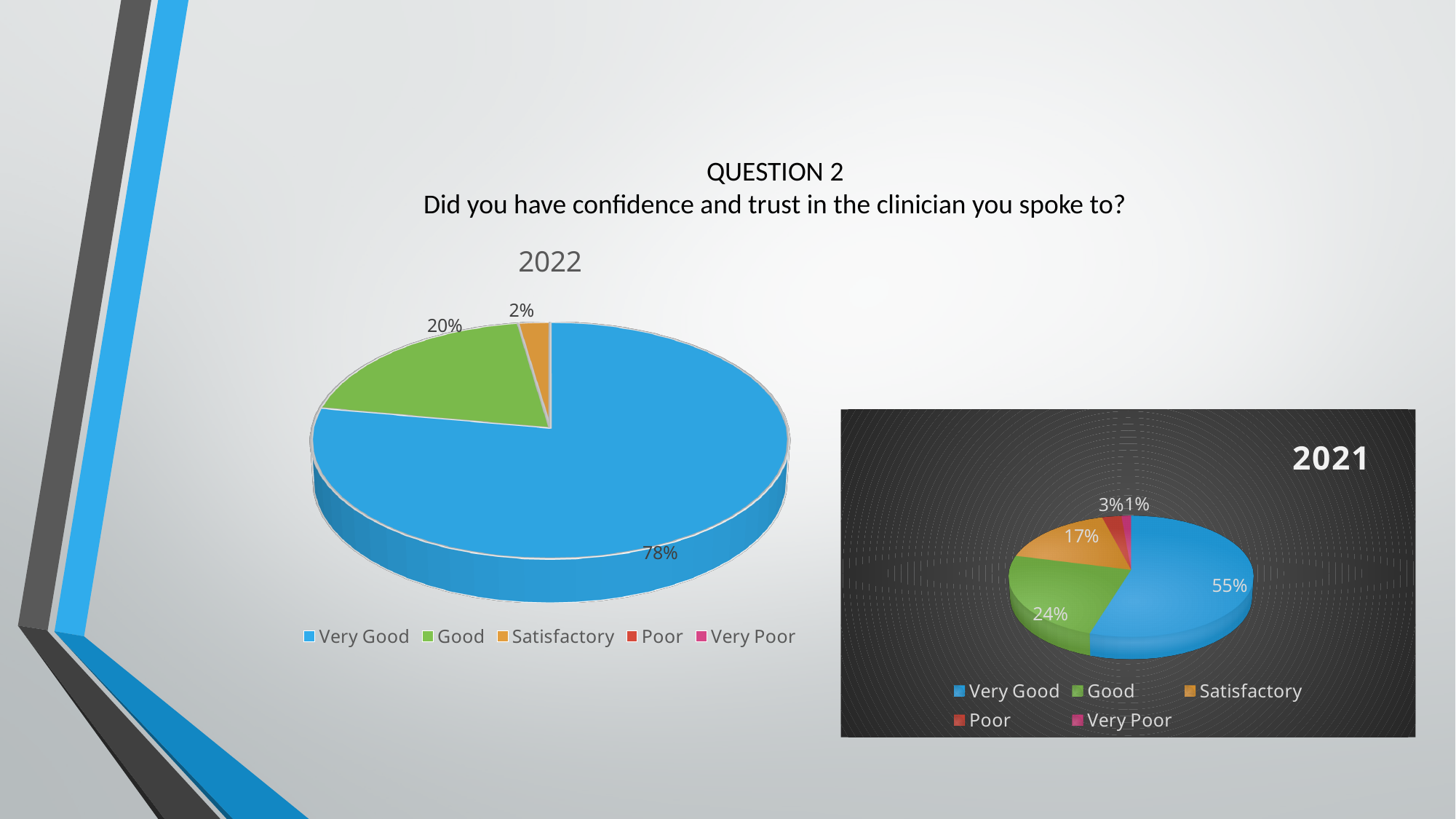
In the 2021 pie chart, what percentage is shown for Poor? 3% Is the Good slice larger in the 2022 chart or the 2021 chart? 2021 In the 2021 pie chart, which category has the smallest slice? Very Poor What type of chart is used for the 2021 data? Pie chart In the 2022 pie chart, what percentage is shown for Good? 20% What is the difference between the Very Good percentage in the 2022 chart and the Very Good percentage in the 2021 chart? 23% In the 2021 pie chart, what percentage is shown for Satisfactory? 17% In the 2021 pie chart, which category has the largest slice? Very Good In the 2022 pie chart, what percentage is shown for Very Good? 78% In the 2021 pie chart, what percentage is shown for Very Good? 55% How many entries does the legend of the 2022 pie chart list? 5 In the 2022 pie chart, what percentage is shown for Satisfactory? 2%